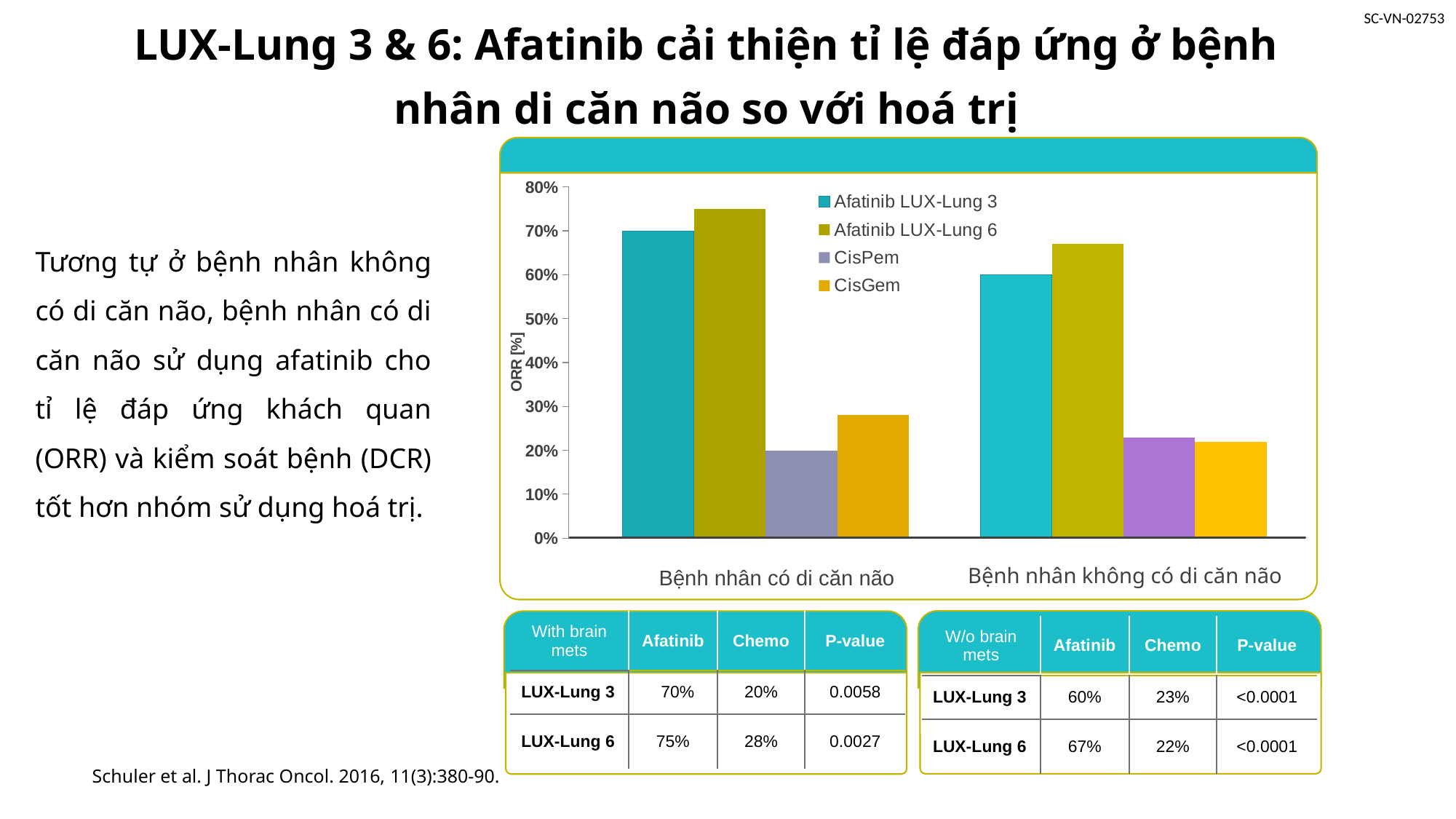
What is the ORR for CisPem in the 'Bệnh nhân có di căn não' group? 20% In the 'Bệnh nhân không có di căn não' group, which is larger: Afatinib LUX-Lung 6 or CisGem? Afatinib LUX-Lung 6 Is the ORR for Afatinib LUX-Lung 6 in the 'Bệnh nhân không có di căn não' group greater or less than 60%? greater Is the ORR for CisGem in the 'Bệnh nhân có di căn não' group greater or less than 30%? less What kind of chart is shown on the slide? bar chart Which series has the lowest ORR in the 'Bệnh nhân có di căn não' group? CisPem Which series has the highest ORR in the 'Bệnh nhân có di căn não' group? Afatinib LUX-Lung 6 How many series does the chart legend list? 4 How many patient groups (categories) are shown on the x axis of the chart? 2 What is the ORR for Afatinib LUX-Lung 3 in the 'Bệnh nhân không có di căn não' group? 60% What is the difference between the ORR for Afatinib LUX-Lung 3 and CisPem in the 'Bệnh nhân có di căn não' group? 50% What is the ORR for Afatinib LUX-Lung 3 in the 'Bệnh nhân có di căn não' group? 70%